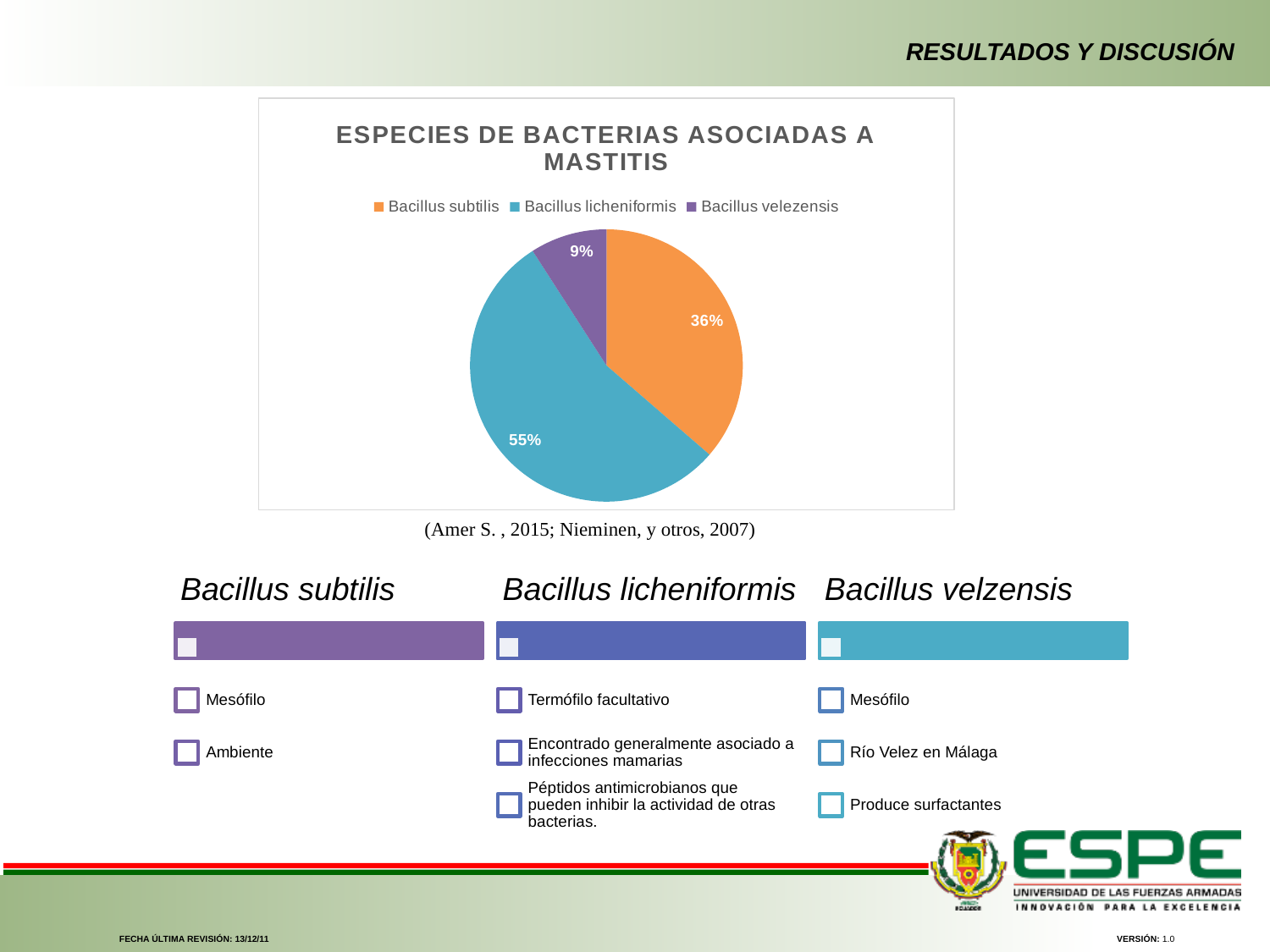
Which is larger, the share for Bacillus subtilis or the share for Bacillus velezensis? Bacillus subtilis What type of chart is shown on the slide? pie chart What percentage of the pie does Bacillus subtilis represent? 36% What is the difference in percentage points between Bacillus licheniformis and Bacillus subtilis? 19 What is the title of the chart? ESPECIES DE BACTERIAS ASOCIADAS A MASTITIS How many slices does the pie chart have? 3 What percentage of the pie does Bacillus velezensis represent? 9% What percentage of the pie does Bacillus licheniformis represent? 55% Which species has the smallest share of the pie? Bacillus velezensis What colour is the slice for Bacillus licheniformis? teal How many entries does the legend list? 3 Which species has the largest share of the pie? Bacillus licheniformis